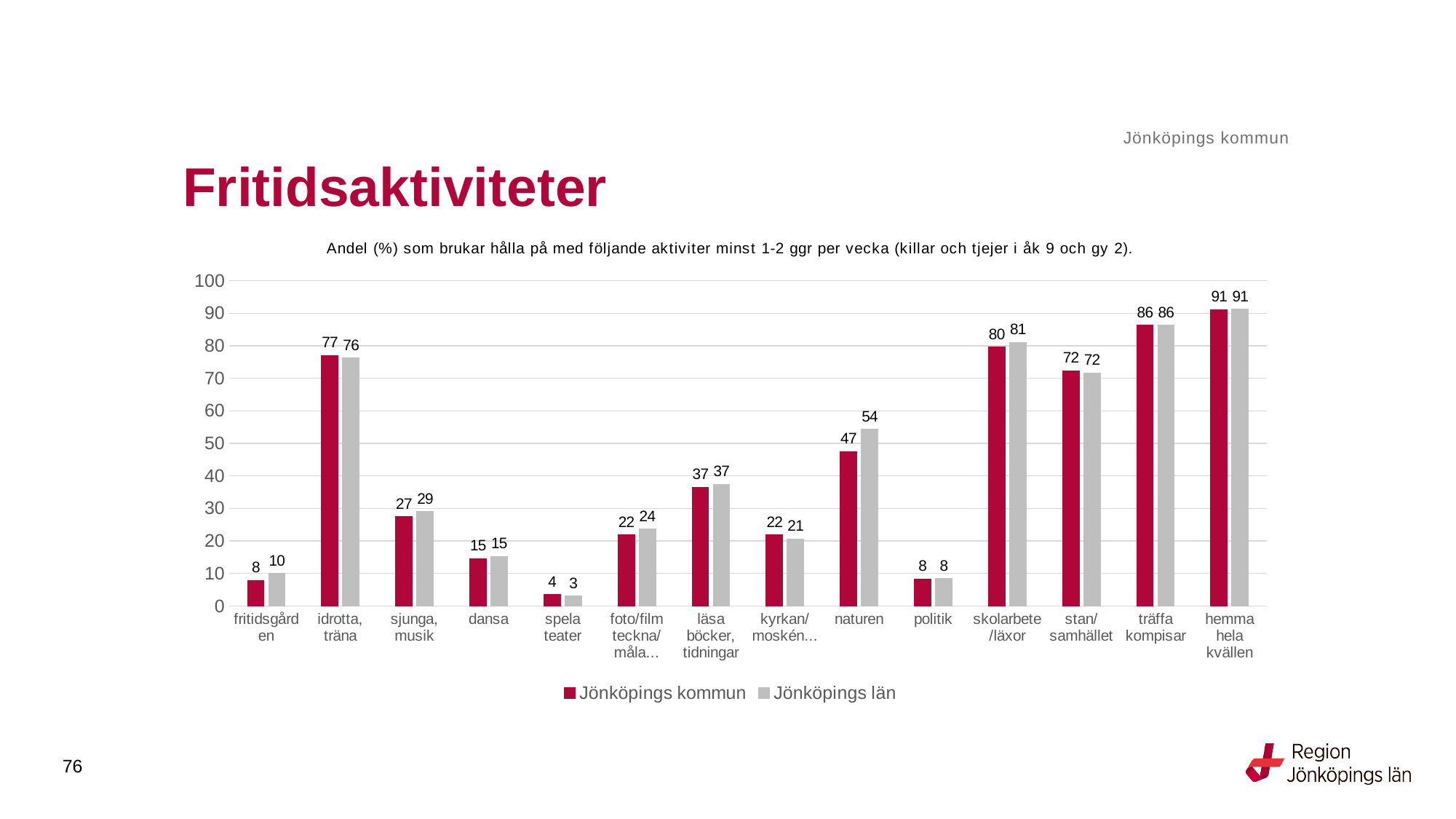
Which category has the lowest value for Jönköpings län? spela teater How many categories are shown on the x axis? 14 What is the difference between Jönköpings län and Jönköpings kommun for 'naturen'? 7 What kind of chart is shown on the slide? bar chart How many series does the legend list? 2 What is the value for Jönköpings län for 'sjunga, musik'? 29 Which is larger for 'idrotta, träna': Jönköpings kommun or Jönköpings län? Jönköpings kommun What is the value for Jönköpings kommun for 'naturen'? 47 What is the difference between Jönköpings kommun and Jönköpings län for 'fritidsgården'? 2 Which category has the highest value for Jönköpings kommun? hemma hela kvällen What is the value for Jönköpings kommun for 'skolarbete/läxor'? 80 Which colour represents Jönköpings län in the chart? grey